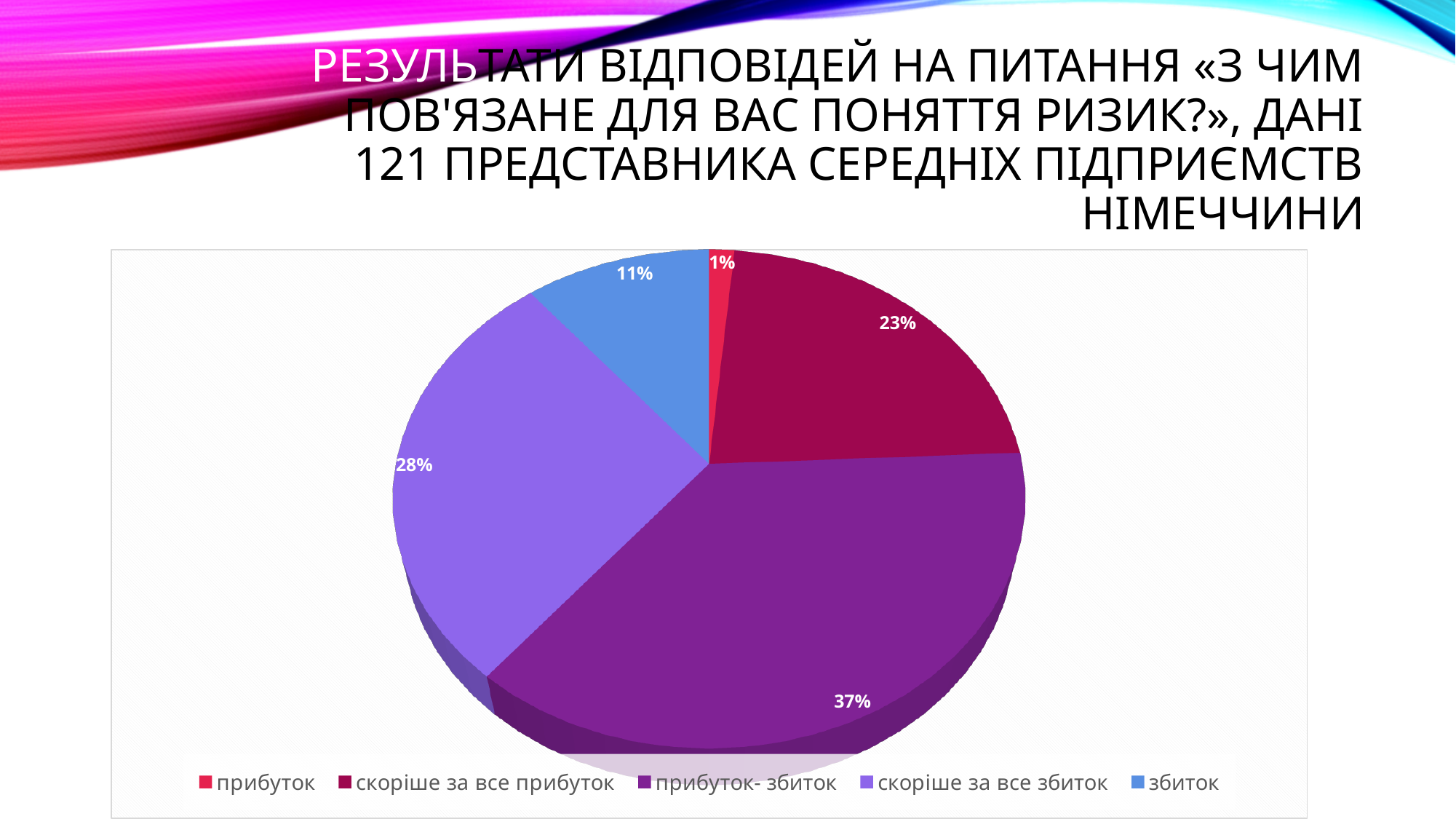
Which is larger: the share for "скоріше за все прибуток" or the share for "збиток"? скоріше за все прибуток What share of the pie does "скоріше за все прибуток" take? 23% What is the difference in percentage points between "прибуток- збиток" and "скоріше за все збиток"? 9 What share of the pie does "прибуток- збиток" take? 37% What share of the pie does "збиток" take? 11% What kind of chart is shown on the slide? pie chart Which category has the smallest slice of the pie? прибуток Which category has the largest slice of the pie? прибуток- збиток How many entries does the legend list? 5 How many categories does the pie chart have? 5